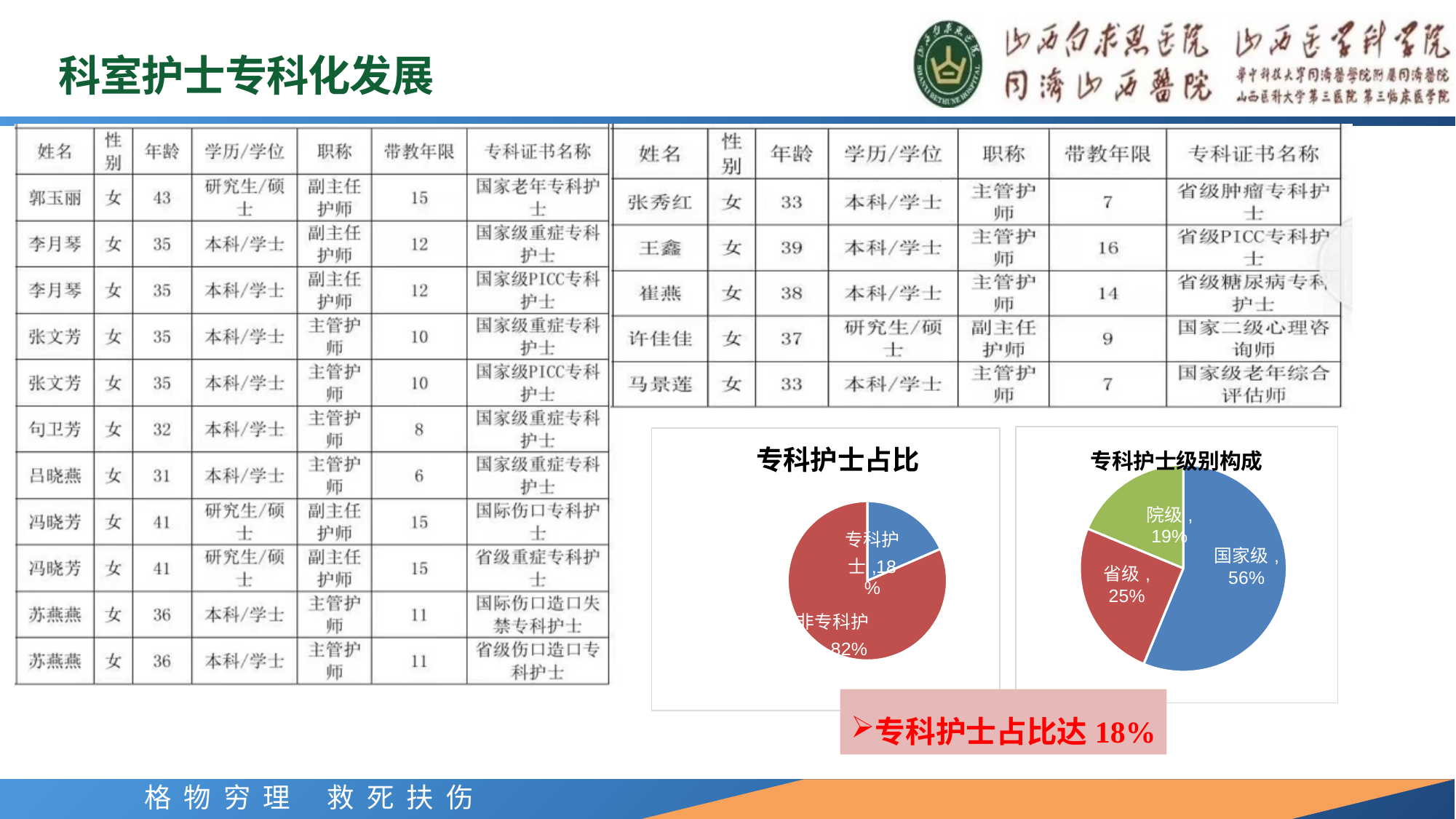
In the "专科护士占比" chart, what share is labelled for 专科护士? 18% In the "专科护士级别构成" chart, which category has the largest share? 国家级 In the "专科护士级别构成" chart, which category has the smallest share? 院级 How many slices does the "专科护士占比" pie chart have? 2 What kind of chart is the "专科护士占比" chart? Pie chart In the "专科护士级别构成" chart, what share is labelled for 省级? 25% In the "专科护士级别构成" chart, what share is labelled for 国家级? 56% In the "专科护士占比" chart, which slice is larger, 专科护士 or 非专科护士? 非专科护士 How many slices does the "专科护士级别构成" pie chart have? 3 In the "专科护士级别构成" chart, what is the difference in percentage points between 国家级 and 省级? 31